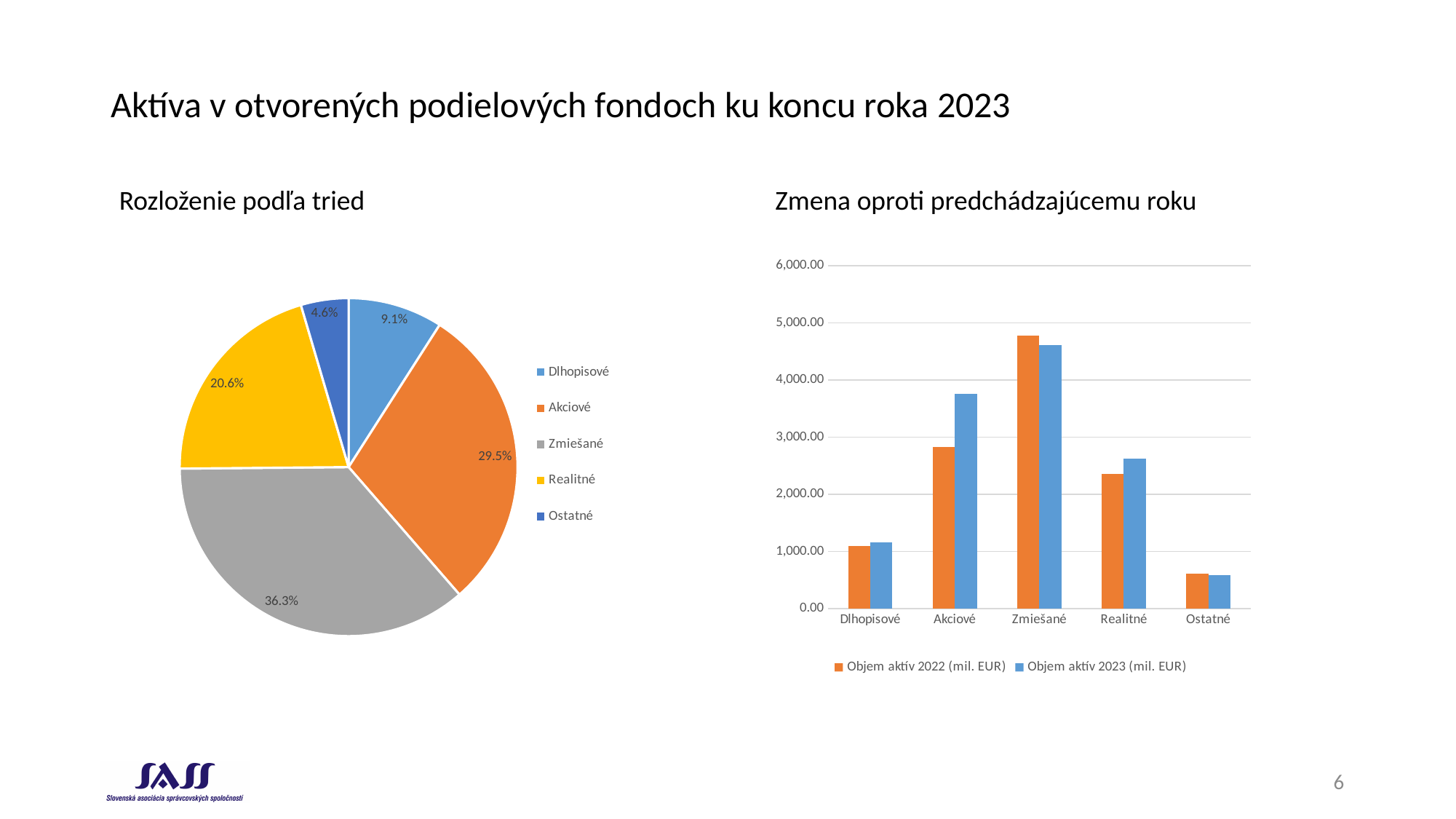
In the pie chart 'Rozloženie podľa tried', which category has the largest share? Zmiešané In the chart 'Zmena oproti predchádzajúcemu roku', for Akciové, which is larger: Objem aktív 2022 (mil. EUR) or Objem aktív 2023 (mil. EUR)? Objem aktív 2023 (mil. EUR) What kind of chart is 'Zmena oproti predchádzajúcemu roku'? bar chart In the pie chart 'Rozloženie podľa tried', how many percentage points larger is the Zmiešané share than the Akciové share? 6.8 In the pie chart 'Rozloženie podľa tried', what share does Zmiešané have? 36.3% In the chart 'Zmena oproti predchádzajúcemu roku', is the value for Akciové in Objem aktív 2023 (mil. EUR) greater or less than 3,000.00? greater In the chart 'Zmena oproti predchádzajúcemu roku', how many series does the legend list? 2 In the chart 'Zmena oproti predchádzajúcemu roku', which category has the highest value for Objem aktív 2023 (mil. EUR)? Zmiešané In the pie chart 'Rozloženie podľa tried', how many categories are shown? 5 In the pie chart 'Rozloženie podľa tried', which category has the smallest share? Ostatné In the pie chart 'Rozloženie podľa tried', what share does Realitné have? 20.6% In the pie chart 'Rozloženie podľa tried', what share does Dlhopisové have? 9.1%